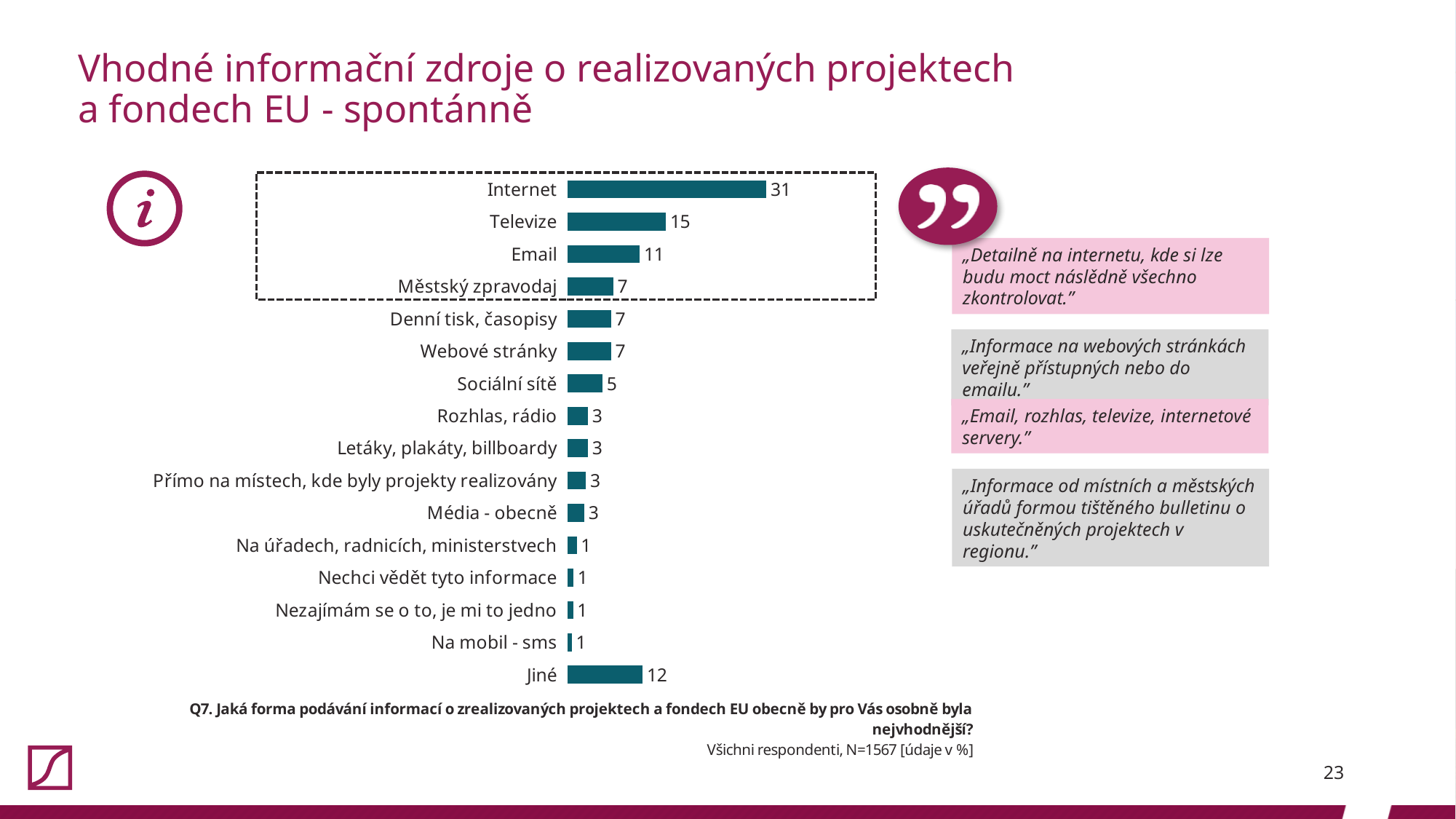
Which is larger, the value for Jiné or the value for Email? Jiné What is the value for Televize? 15 How many categories are shown in the chart? 16 Which is larger, the value for Televize or the value for Webové stránky? Televize What is the value for Internet? 31 How many categories are enclosed in the dashed box at the top of the chart? 4 What kind of chart is shown on the slide? Bar chart What is the value for Sociální sítě? 5 What is the difference between the values for Internet and Televize? 16 Which category has the highest value? Internet What is the difference between the values for Email and Městský zpravodaj? 4 What is the value for Jiné? 12